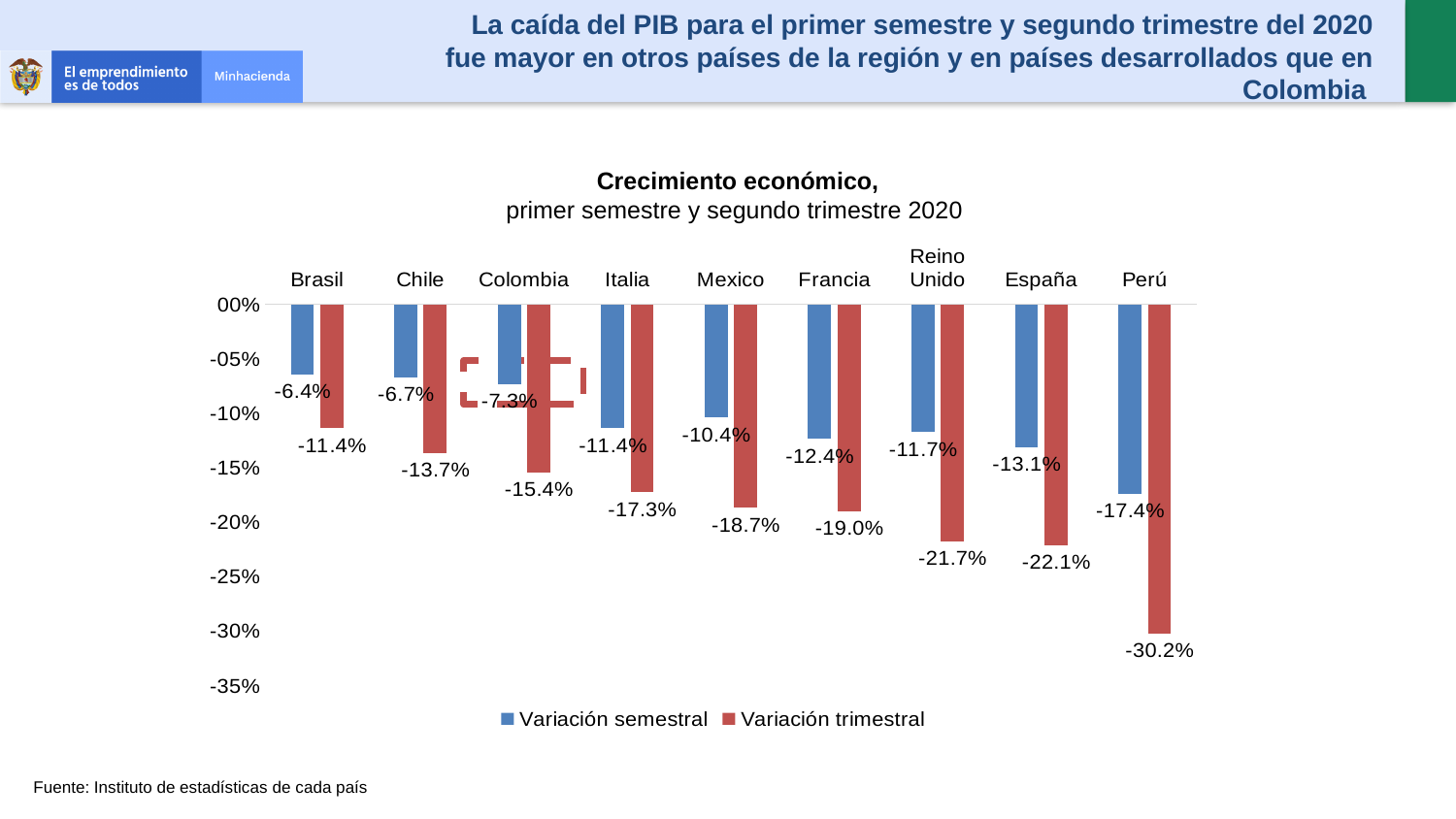
What is the Variación trimestral value for Francia? -19.0% What is the Variación semestral value for Reino Unido? -11.7% What is the Variación trimestral value for Colombia? -15.4% What is the difference in percentage points between Perú's Variación trimestral (-30.2%) and its Variación semestral (-17.4%)? 12.8 percentage points How many countries are shown on the chart? 9 Which is the larger decline: the Variación semestral for Italia or for Mexico? Italia How many series does the legend list? 2 Is the Variación trimestral value for España greater or less than -20%? less Which country has the most negative Variación trimestral value? Perú What kind of chart is shown on the slide? Bar chart Which country has the least negative (smallest decline) Variación semestral value? Brasil Which series is shown in red in the legend? Variación trimestral